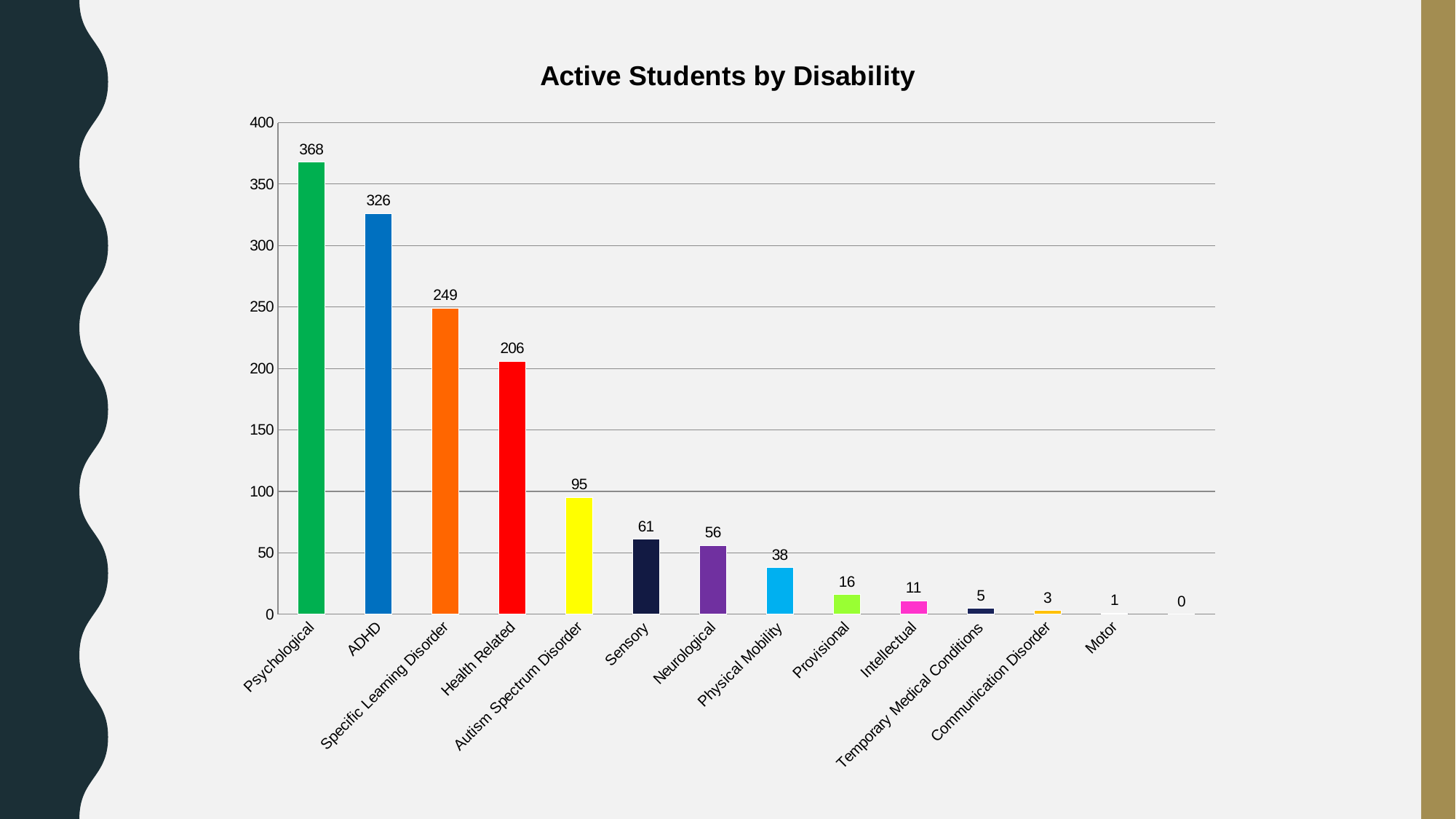
Is the value for Health Related greater or less than 200? greater Which is larger, the value for Sensory or the value for Neurological? Sensory What is the value for Autism Spectrum Disorder? 95 What is the difference between the values for Specific Learning Disorder and Health Related? 43 What is the value for Temporary Medical Conditions? 5 What is the title of the chart? Active Students by Disability Which category has the highest value? Psychological Which is larger, the value for Provisional or the value for Intellectual? Provisional What is the difference between the values for Psychological and ADHD? 42 What kind of chart is shown on the slide? bar chart What is the value for Psychological? 368 What is the value for Motor? 1